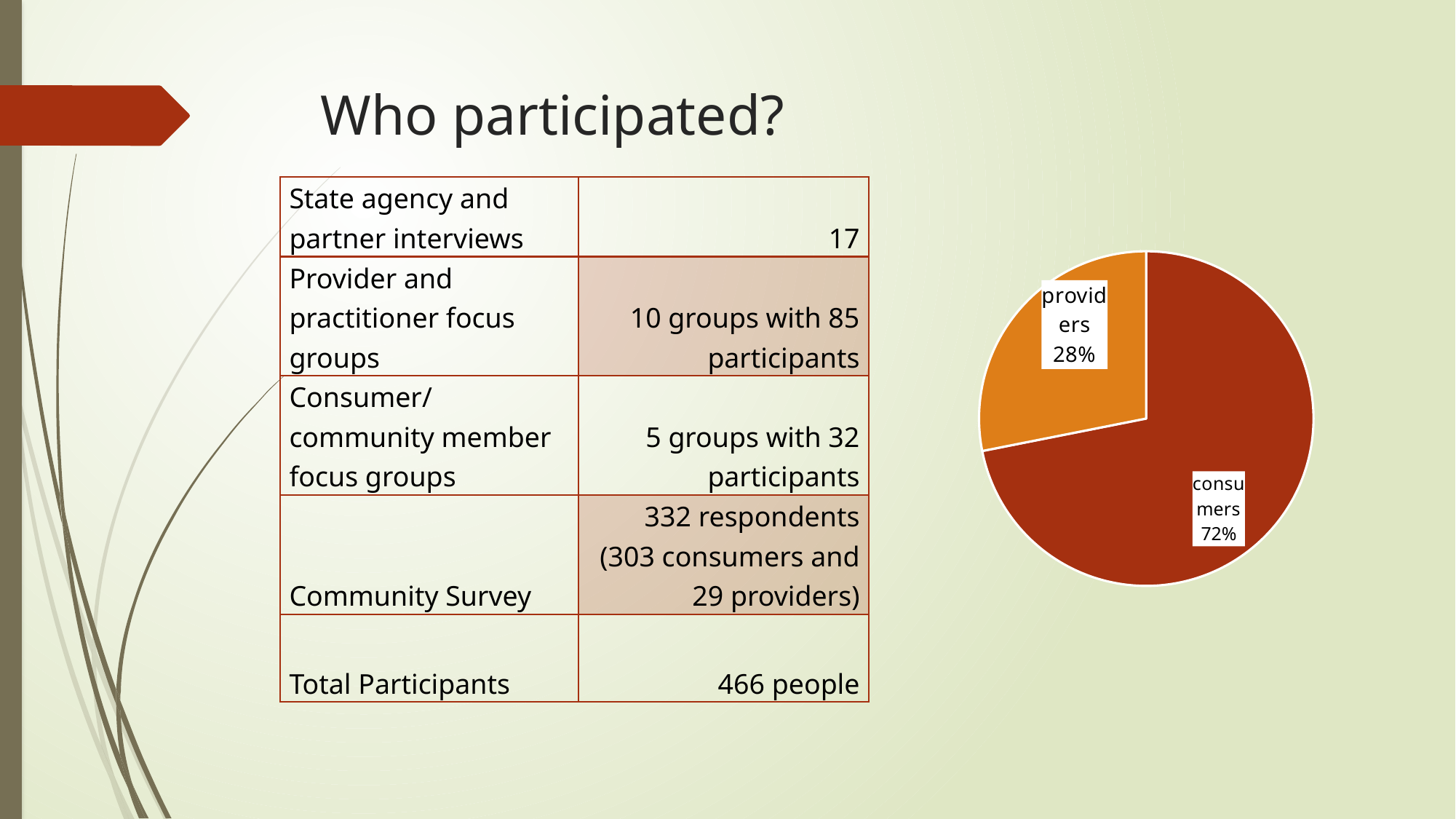
What colour is the consumers slice of the pie chart? dark red What share of the pie chart is labelled providers? 28% What colour is the providers slice of the pie chart? orange Which slice of the pie chart is the smallest? providers Which slice is larger, consumers or providers? consumers What is the difference in percentage points between the consumers slice and the providers slice? 44 How many slices does the pie chart have? 2 What share of the pie chart is labelled consumers? 72% Which slice of the pie chart is the largest? consumers Is the share for providers greater or less than 50%? less What kind of chart is shown on the slide? pie chart